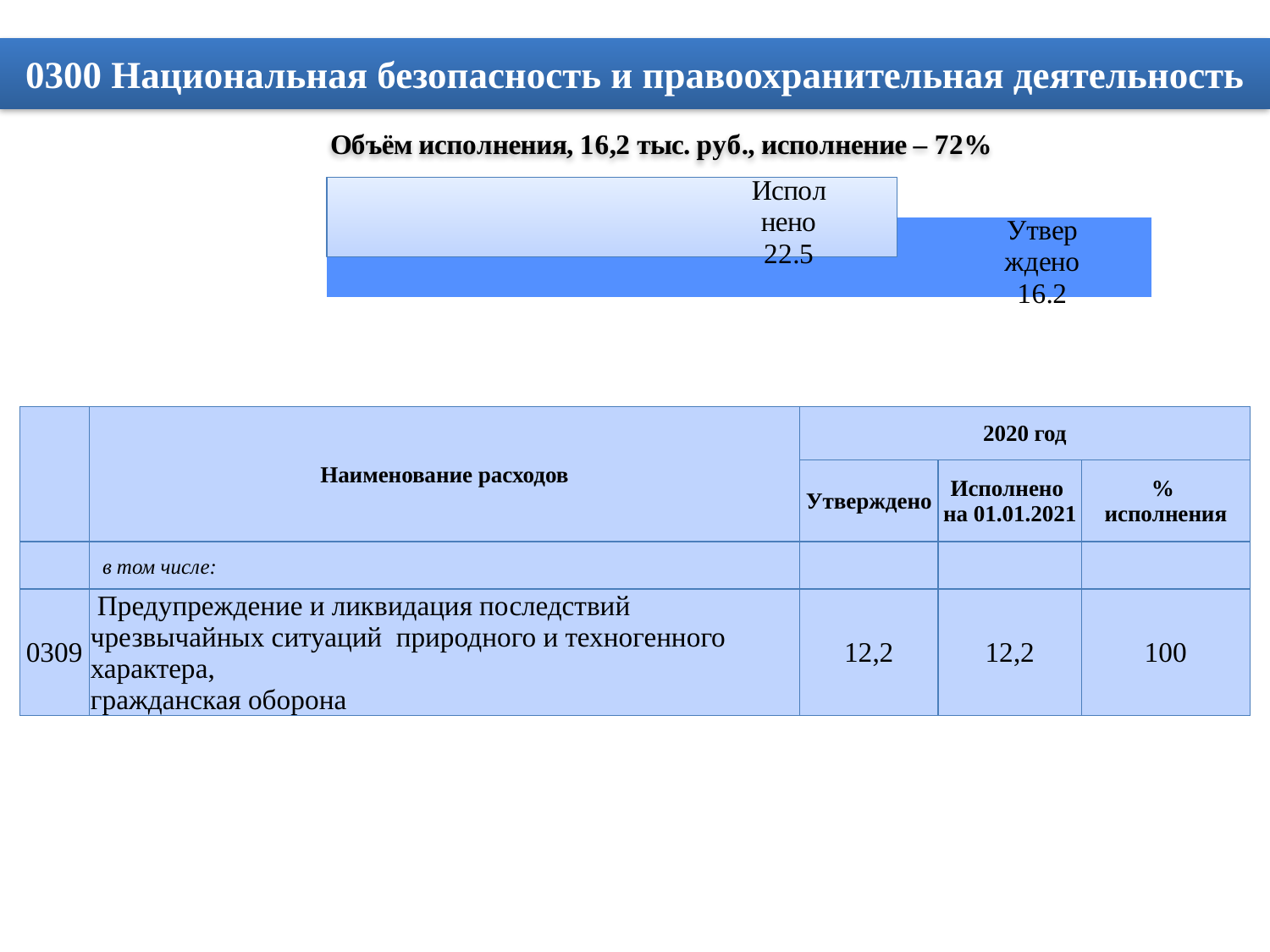
What is the difference between the printed values for Исполнено (22.5) and Утверждено (16.2)? 6.3 What value is printed on the bar labelled Исполнено? 22.5 Are the bars in the chart oriented horizontally or vertically? horizontally How many bars does the chart on the slide contain? 2 What value is printed on the bar labelled Утверждено? 16.2 What are the two category labels printed on the bars of the chart? Исполнено and Утверждено Which bar in the chart is drawn in the darker blue colour? Утверждено What kind of chart is shown on the slide? bar chart